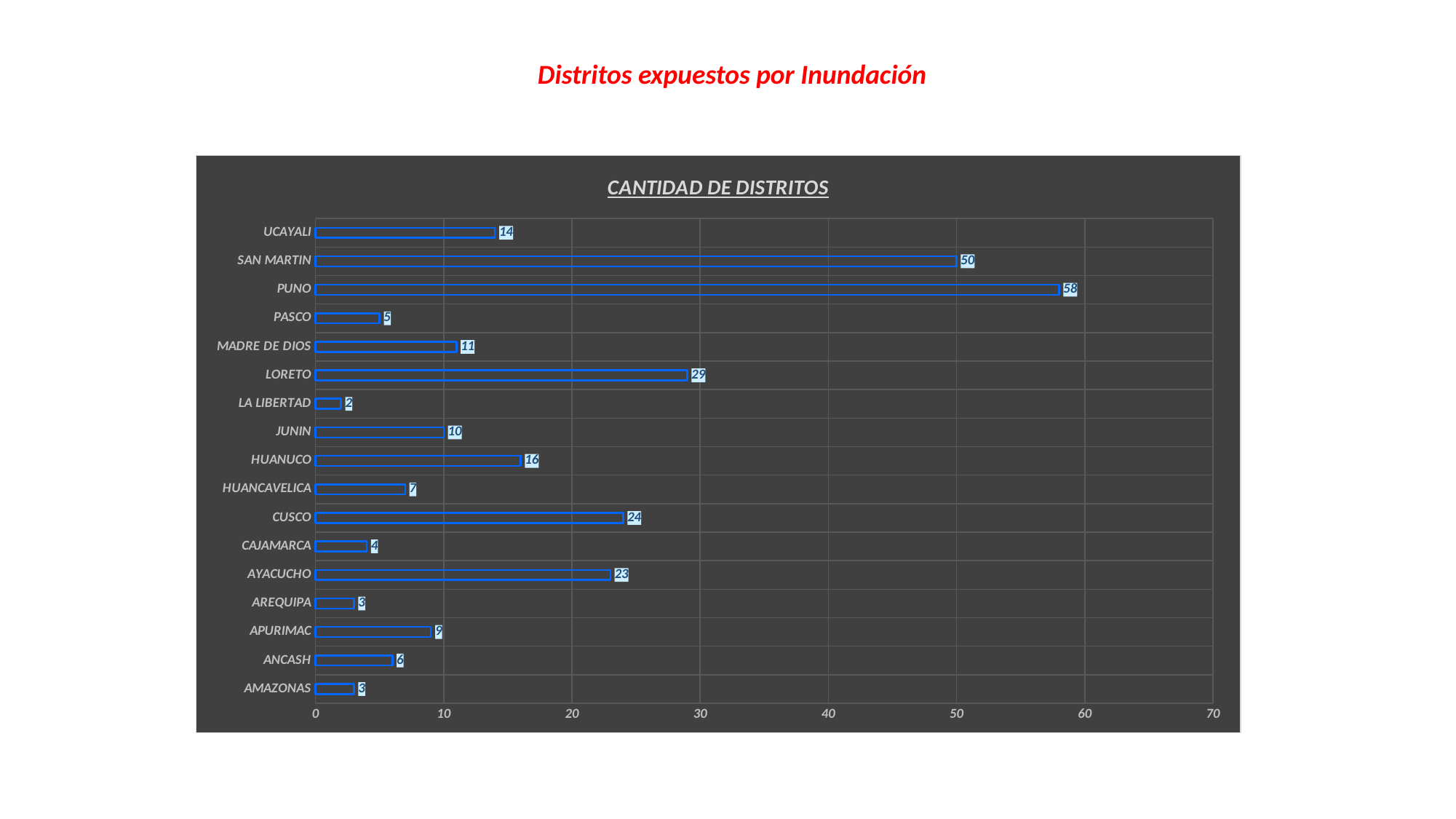
How many regions are shown on the chart? 17 What kind of chart is shown on the slide? bar chart Is the value for LORETO greater or less than 20? greater Which region has the highest number of districts? PUNO What is the difference between the values for PUNO and SAN MARTIN? 8 What is the value for MADRE DE DIOS? 11 What is the value for PUNO? 58 What is the difference between the values for CUSCO and AYACUCHO? 1 What is the value for LORETO? 29 Which is larger, the value for HUANUCO or the value for UCAYALI? HUANUCO Which region has the lowest number of districts? LA LIBERTAD What is the title of the chart? CANTIDAD DE DISTRITOS